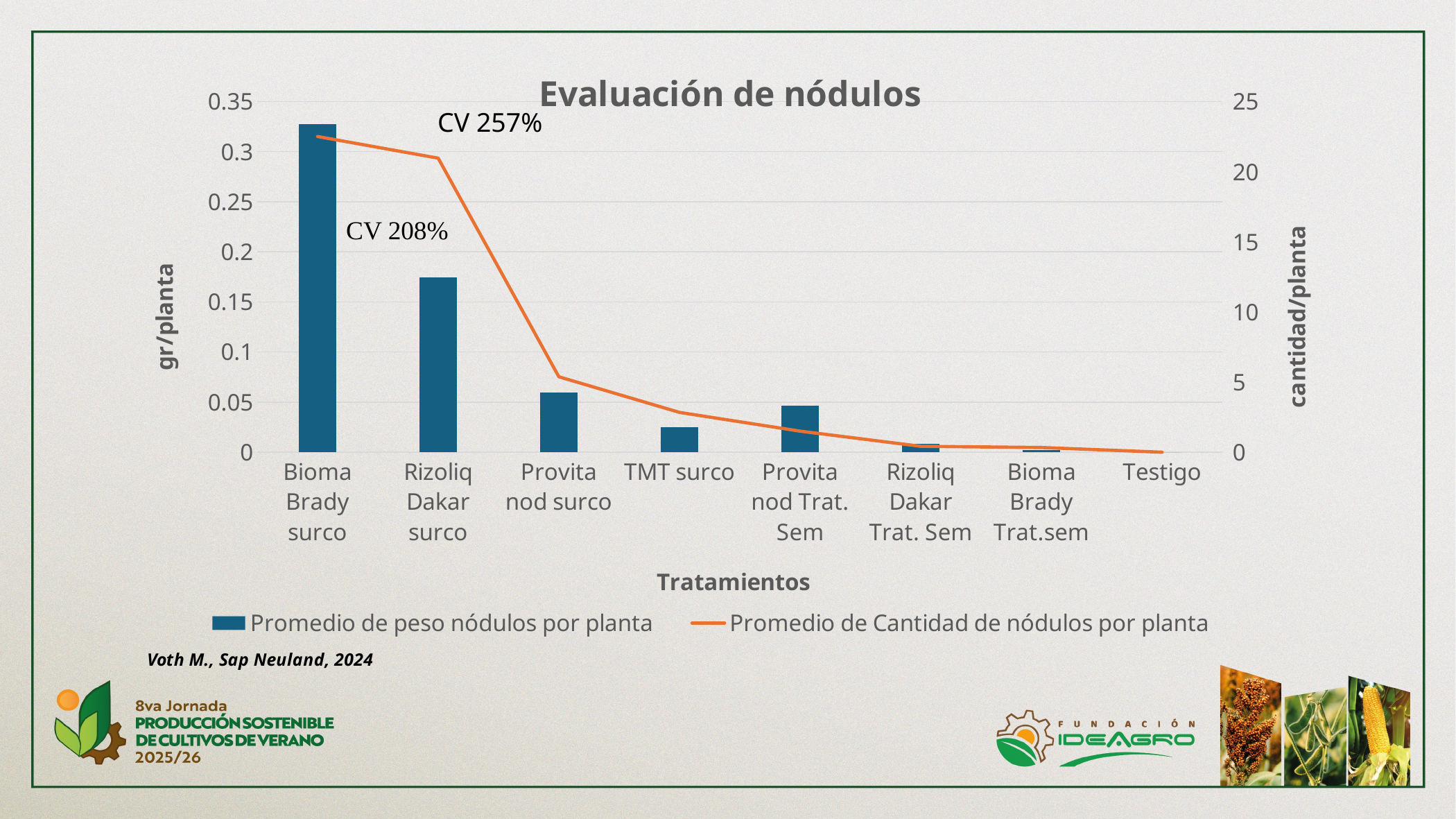
Is the line value for Provita nod surco greater or less than 10 cantidad/planta? less What kind of chart is shown on the slide? A combined bar and line chart What is the title of the chart? Evaluación de nódulos Which treatment has the highest average nodule weight per plant (bars)? Bioma Brady surco Which has the larger bar value, Provita nod surco or TMT surco? Provita nod surco Is the bar value for Rizoliq Dakar surco greater or less than 0.2 gr/planta? less Is the line value for Bioma Brady surco greater or less than 20 cantidad/planta? greater How many series does the legend list? 2 Do the values generally rise or fall moving from left to right along the x axis? fall How many treatments (categories) are shown on the x axis? 8 Which treatment has the highest average number of nodules per plant (line)? Bioma Brady surco